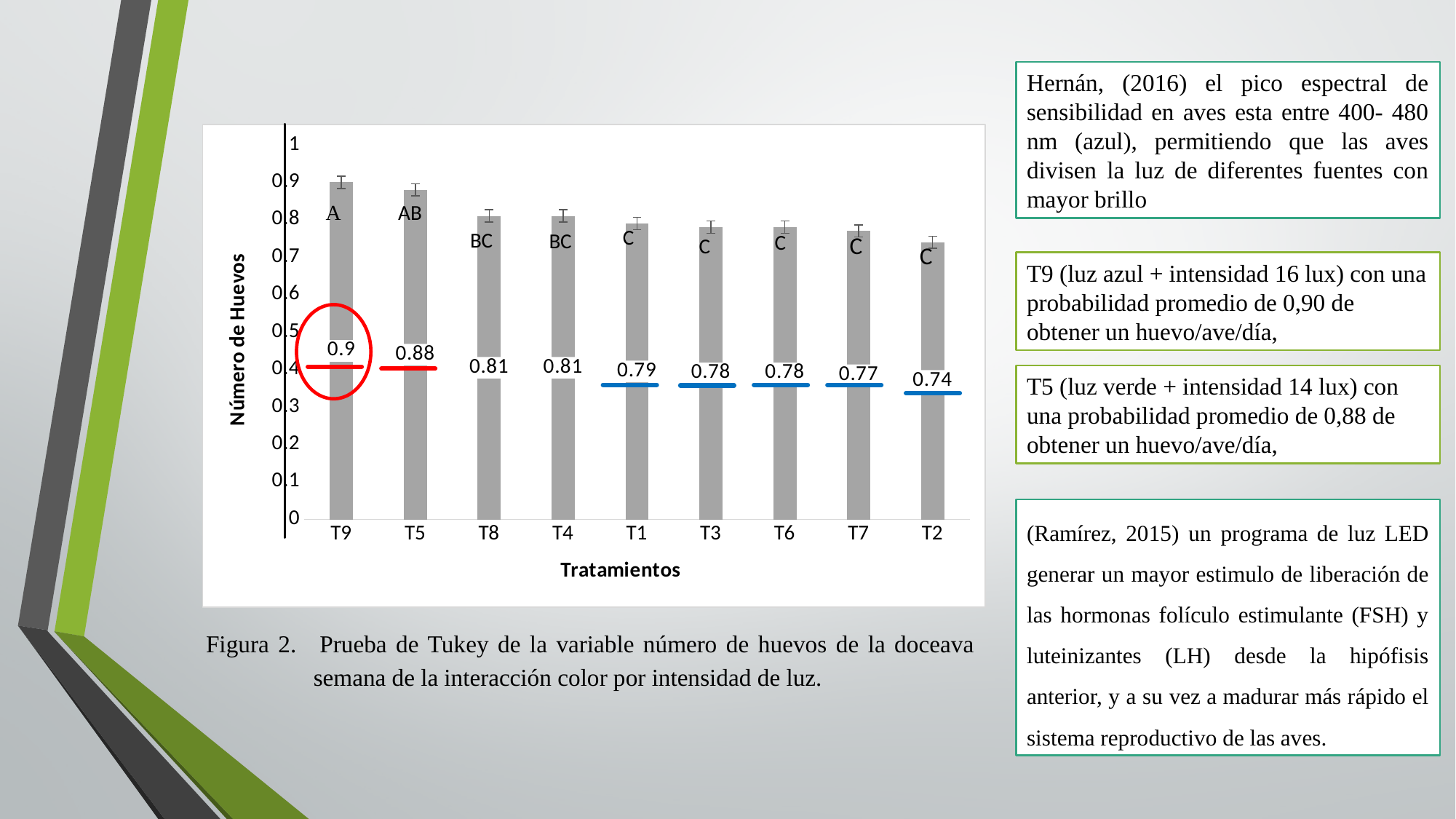
Do the values rise or fall from T9 to T2 along the x axis? Fall What is the value for T7? 0.77 How many treatments are shown on the x axis? 9 What kind of chart is shown? Bar chart What is the value for T9? 0.9 Which treatment has the lowest number of eggs? T2 What is the difference between the values for T9 and T2? 0.16 What is the value for T2? 0.74 Which is larger, the value for T5 or the value for T8? T5 Which treatment has the highest number of eggs? T9 What is the value for T5? 0.88 What is the label of the y axis? Número de Huevos